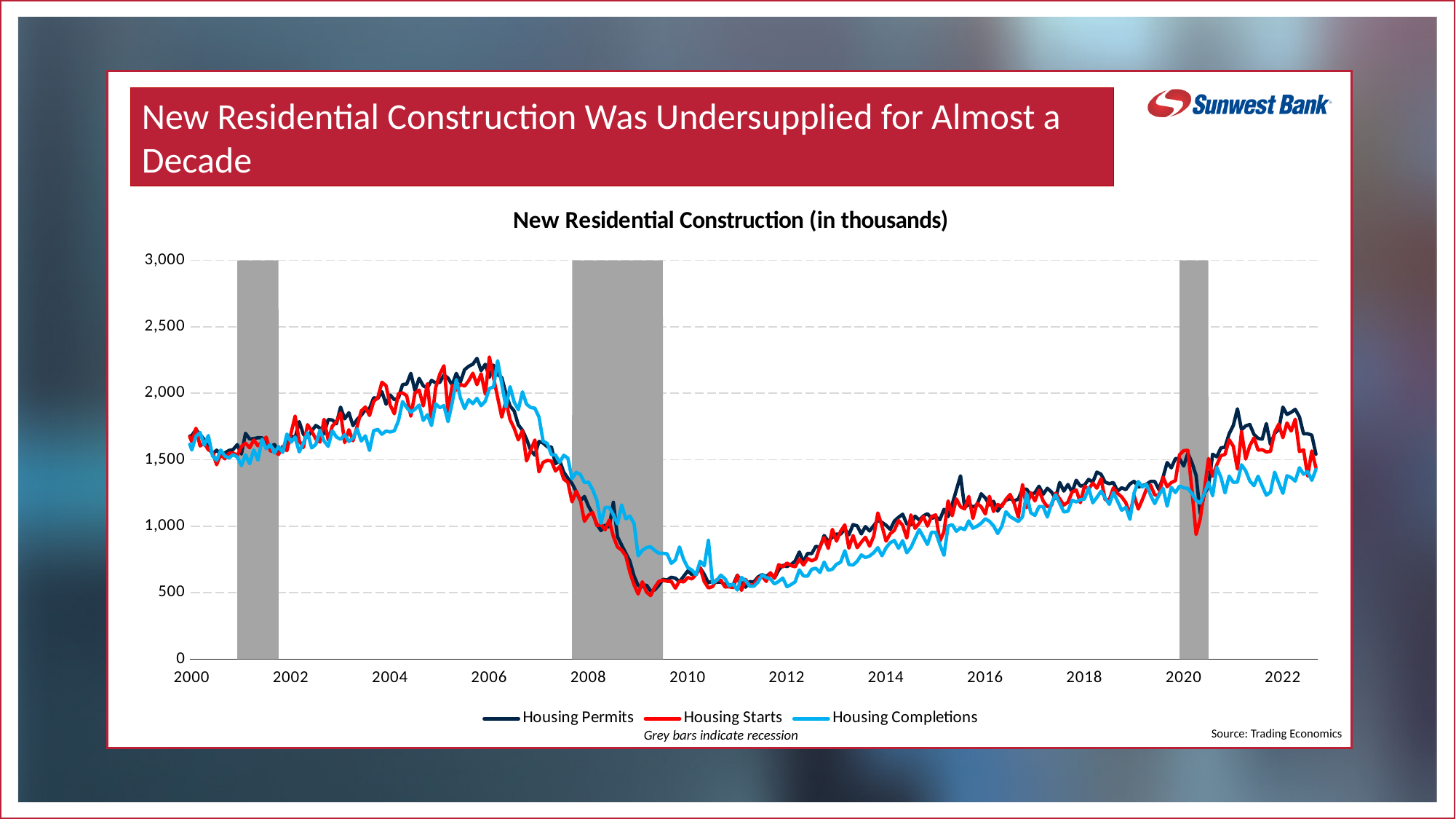
Do the Housing Permits values rise or fall between 2011 and 2019? rise What is the title of the chart? New Residential Construction (in thousands) What kind of chart is shown on the slide? line chart Is the value for Housing Completions in 2011 greater or less than 1,000? less Is the value for Housing Completions in 2016 greater or less than 1,500? less How many series does the legend list? 3 Is the value for Housing Permits in 2006 greater or less than 2,000? greater Which series is drawn in red? Housing Starts Do the Housing Starts values rise or fall between 2006 and 2009? fall